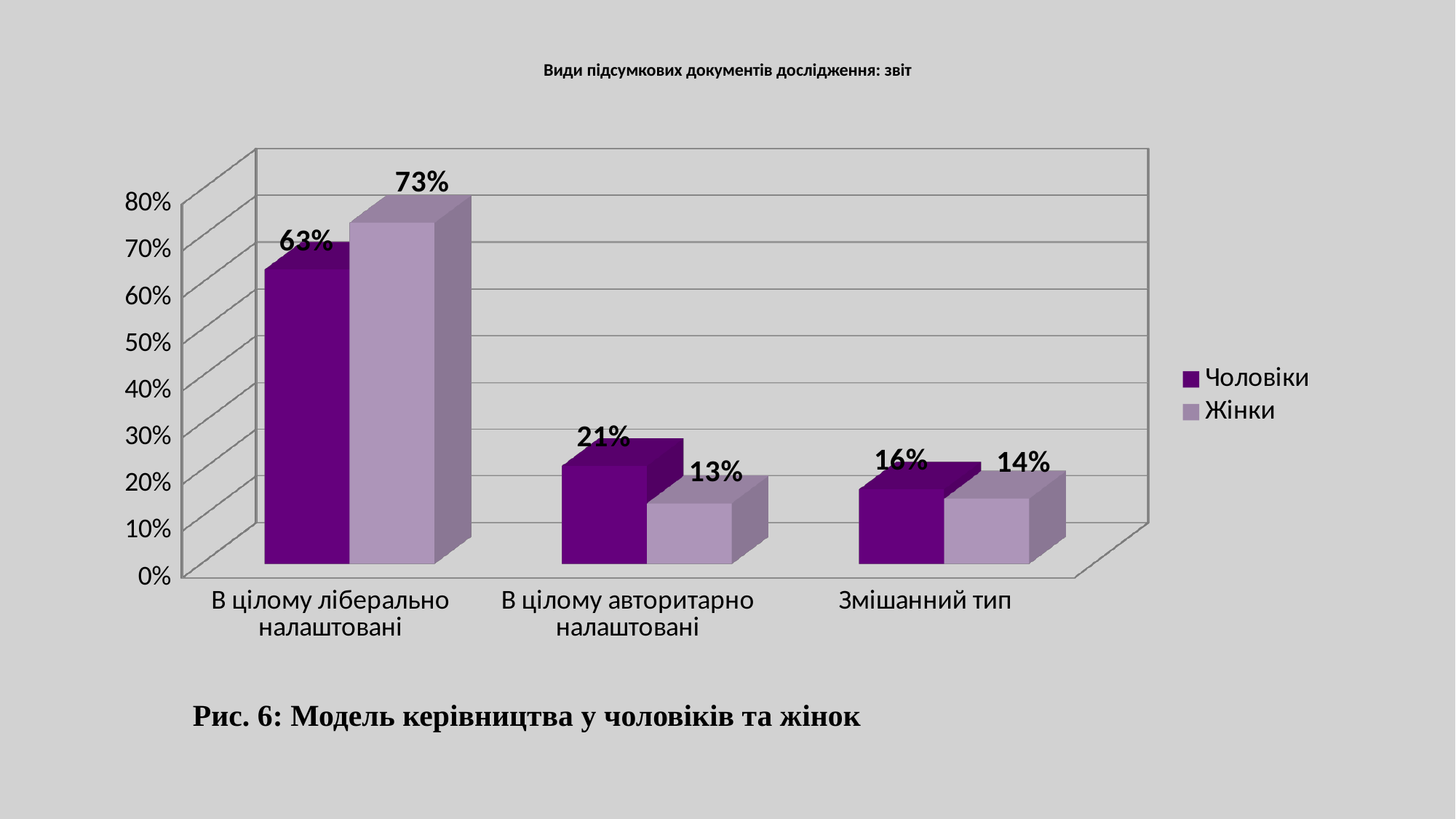
What is the value for Чоловіки in the category 'В цілому ліберально налаштовані'? 63% How many categories are shown on the x axis? 3 What are the two series named in the legend? Чоловіки and Жінки Which category has the lowest value for Чоловіки? Змішанний тип Which category has the highest value for Жінки? В цілому ліберально налаштовані What is the difference between the Чоловіки and Жінки values in the category 'В цілому авторитарно налаштовані'? 8% What kind of chart is shown on the slide? Bar chart Which is larger in the category 'В цілому авторитарно налаштовані': the value for Чоловіки or for Жінки? Чоловіки How many series does the legend list? 2 What is the value for Жінки in the category 'Змішанний тип'? 14% What is the difference between the Жінки and Чоловіки values in the category 'В цілому ліберально налаштовані'? 10% What is the value for Жінки in the category 'В цілому авторитарно налаштовані'? 13%